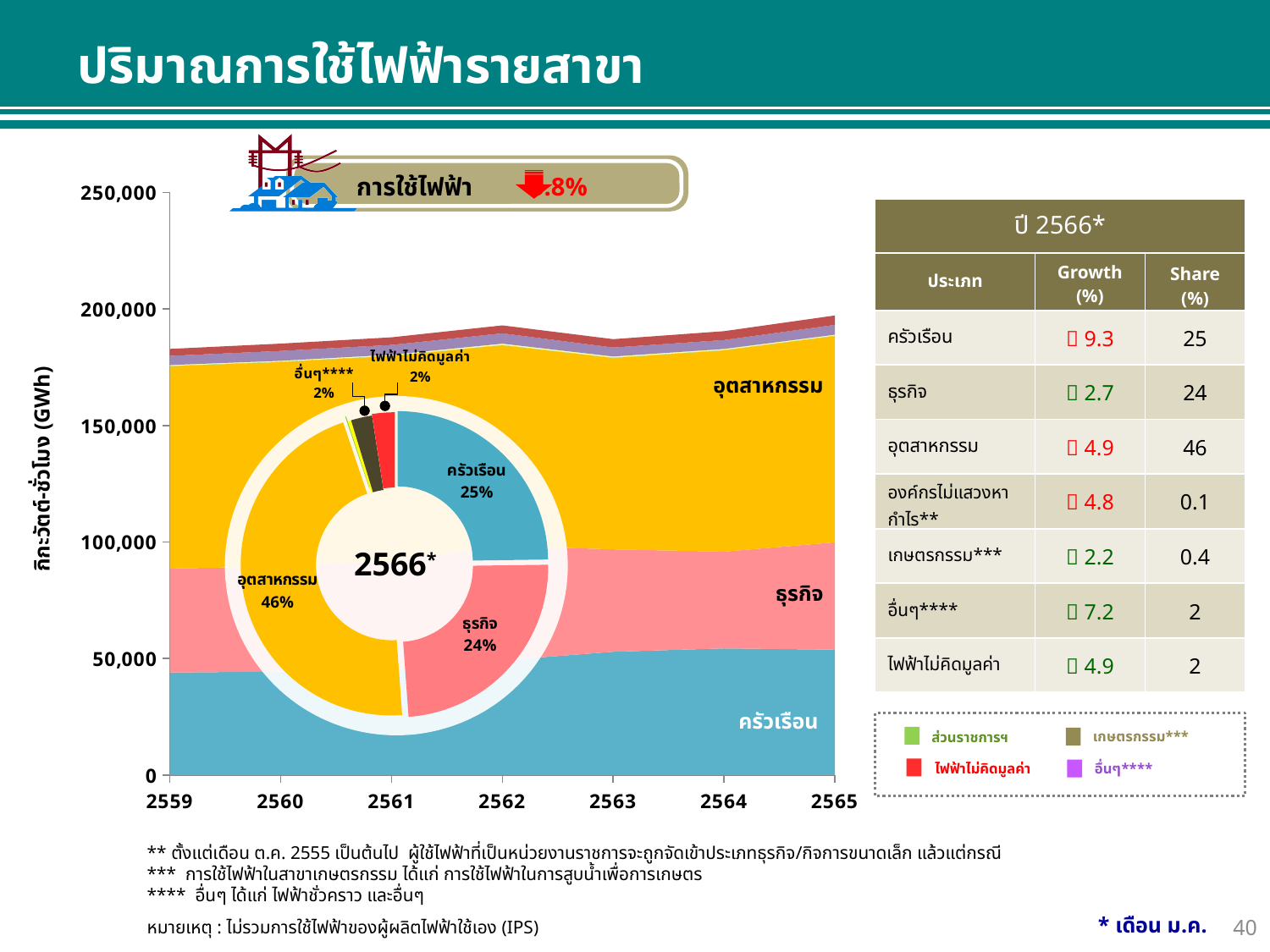
In the donut chart, what share does ธุรกิจ have? 24% In the donut chart, what share does อุตสาหกรรม have? 46% In the stacked area chart, how many years are shown on the x axis? 7 What kind of chart is the large chart with years 2559 to 2565 on the x axis? Stacked area chart In the donut chart, what is the difference in percentage points between the shares of อุตสาหกรรม and ครัวเรือน? 21 What unit is shown on the y axis of the stacked area chart? กิกะวัตต์-ชั่วโมง (GWh) In the donut chart, what share does ครัวเรือน have? 25% In the stacked area chart, is the total electricity consumption in 2565 greater or less than 150,000? greater What year label is shown in the centre of the donut chart? 2566* In the donut chart, which category has the largest share? อุตสาหกรรม In the donut chart, what share does ไฟฟ้าไม่คิดมูลค่า have? 2% In the donut chart, which share is larger, ครัวเรือน or ธุรกิจ? ครัวเรือน